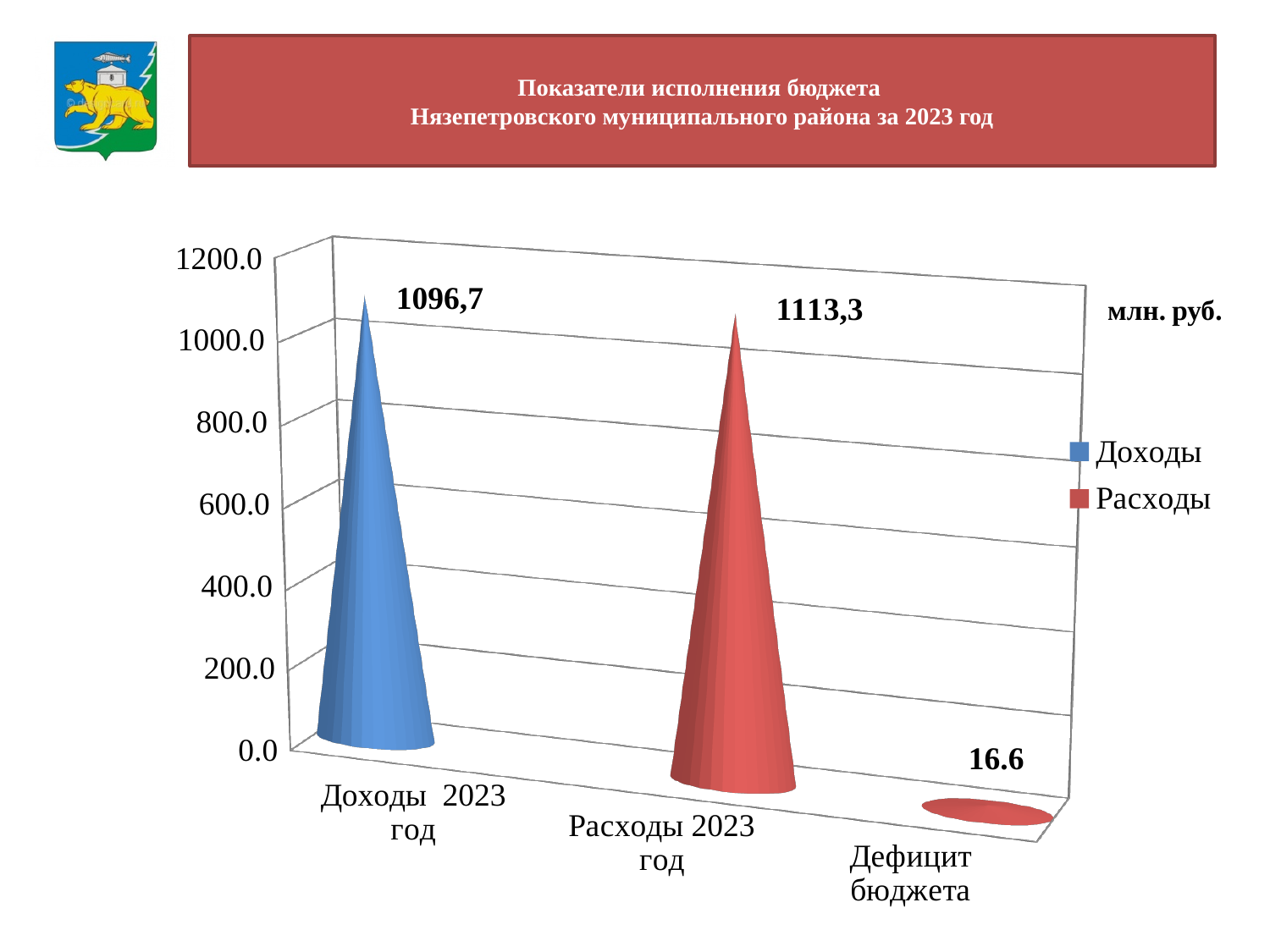
How many categories are shown on the x axis? 3 What value is shown for Расходы 2023 год? 1113,3 Is the value for Доходы 2023 год greater or less than 1000.0? greater What is the difference between Расходы 2023 год and Доходы 2023 год? 16,6 Which category has the lowest value? Дефицит бюджета How many series does the legend list? 2 Which category has the highest value? Расходы 2023 год What value is shown for Дефицит бюджета? 16.6 Which is larger, Доходы 2023 год or Расходы 2023 год? Расходы 2023 год What value is shown for Доходы 2023 год? 1096,7 What unit of measurement is indicated on the chart? млн. руб. What kind of chart is shown on the slide? bar chart